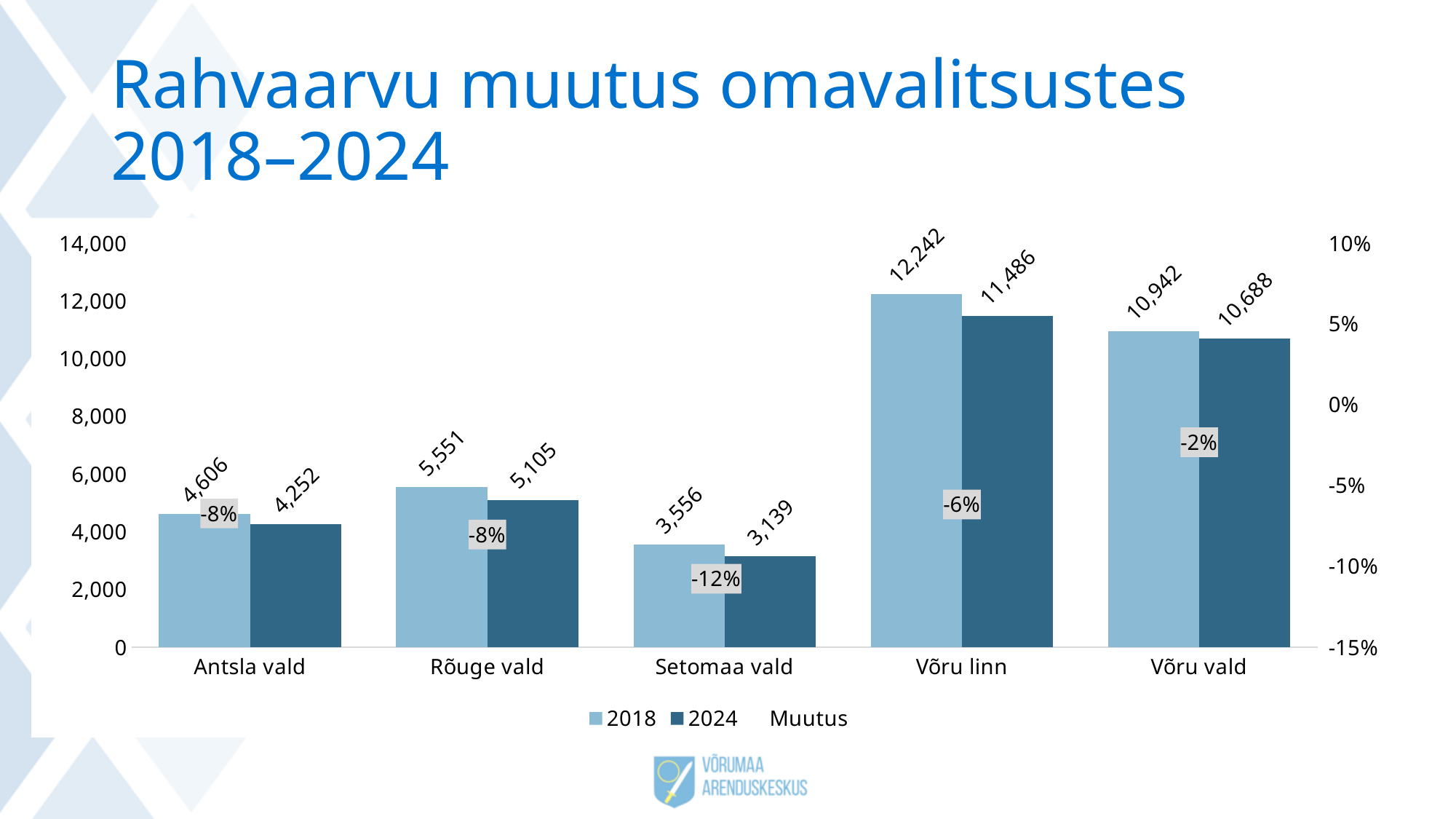
How many categories are shown on the x axis? 5 What is the 2018 value for Võru linn? 12,242 Which category has the highest 2024 value? Võru linn What kind of chart is shown on the slide? bar chart What is the difference between the 2018 and 2024 values for Võru vald? 254 How many series does the legend list? 3 Which is larger, the 2024 value for Antsla vald or the 2024 value for Rõuge vald? Rõuge vald What is the title of the slide? Rahvaarvu muutus omavalitsustes 2018–2024 What is the 2024 value for Setomaa vald? 3,139 What is the Muutus value shown for Setomaa vald? -12% Which category has the lowest 2018 value? Setomaa vald Is the 2018 value for Võru linn greater or less than 12,000? greater